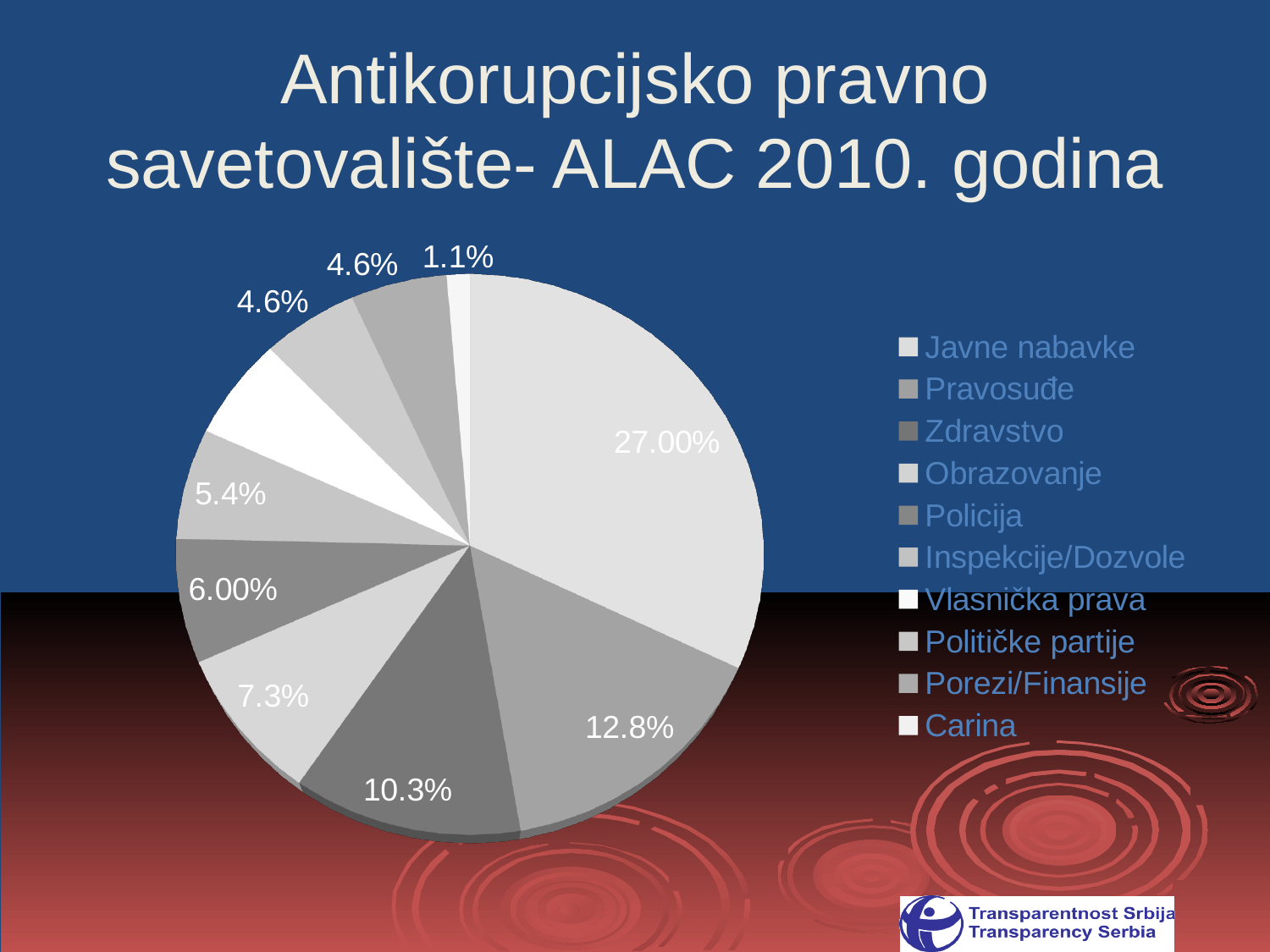
What is the share of the Zdravstvo slice in the pie chart? 10.3% What is the largest percentage shown on the pie chart? 27.00% What is the title of the slide with the pie chart? Antikorupcijsko pravno savetovalište- ALAC 2010. godina How many slices are labelled 4.6% on the pie chart? 2 How many categories does the legend of the pie chart list? 10 What type of chart is shown on the slide? pie chart Which legend entry is listed last in the pie chart legend? Carina Which is larger, the Javne nabavke slice or the Pravosuđe slice? Javne nabavke What is the smallest percentage labelled on the pie chart? 1.1% What is the difference in percentage points between the 27.00% slice and the 12.8% slice? 14.2 What is the share of the largest slice, Javne nabavke, in the pie chart? 27.00% What is the share of the Pravosuđe slice in the pie chart? 12.8%